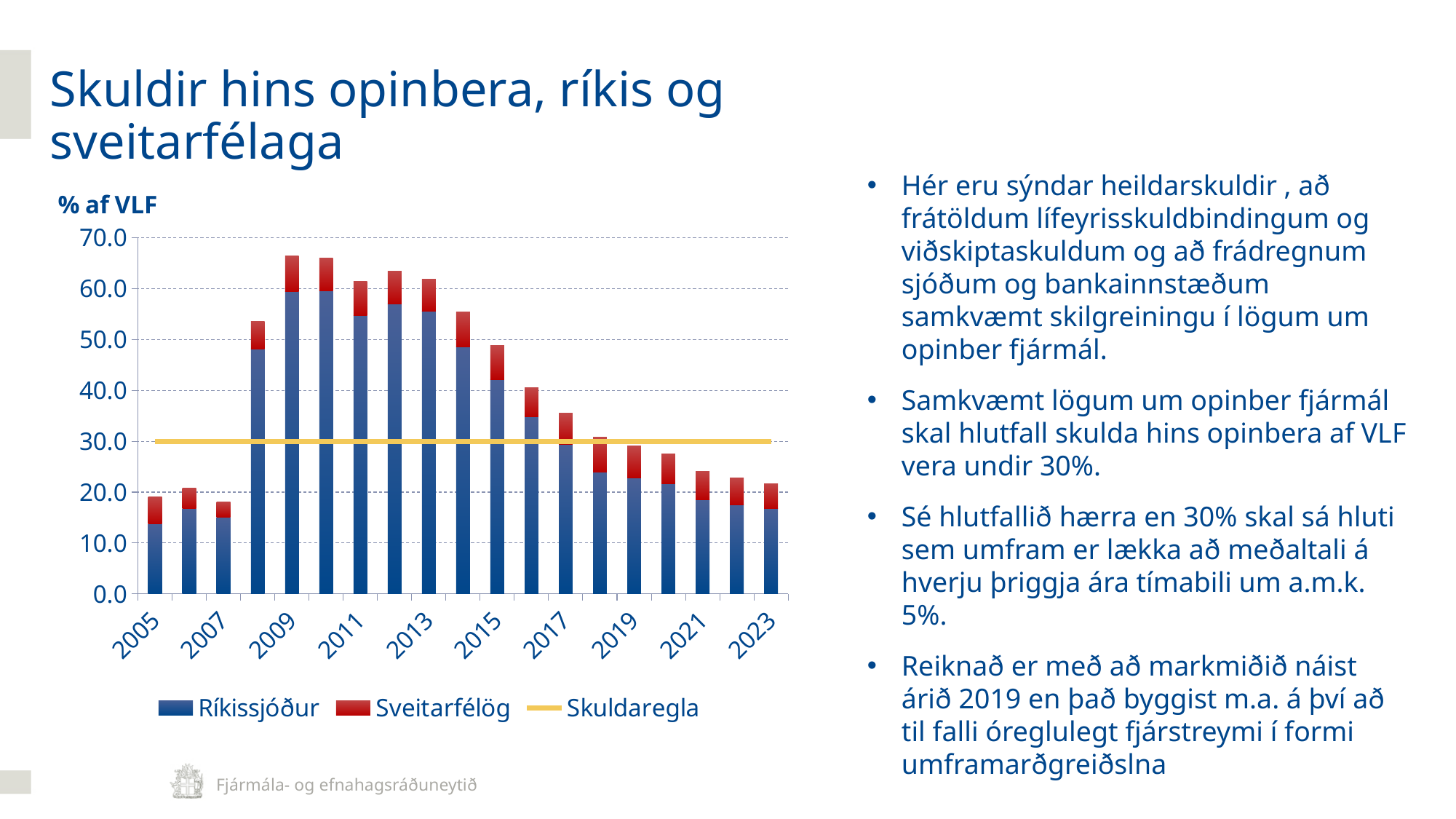
What label is shown on the vertical axis of the chart? % af VLF Is the total value for 2021 greater or less than 30? less How many years (bars) are plotted on the chart? 19 How many series does the chart legend list? 3 Is the total value for 2017 greater or less than 30? greater Which legend entry is represented by the yellow line? Skuldaregla Which year has the highest total debt in the chart? 2009 Is the total value for 2009 greater or less than 60? greater Do the total values rise or fall from 2009 to 2023? Fall Which is larger, the total value for 2009 or for 2023? 2009 What kind of chart is shown on the slide? Stacked bar chart with a line